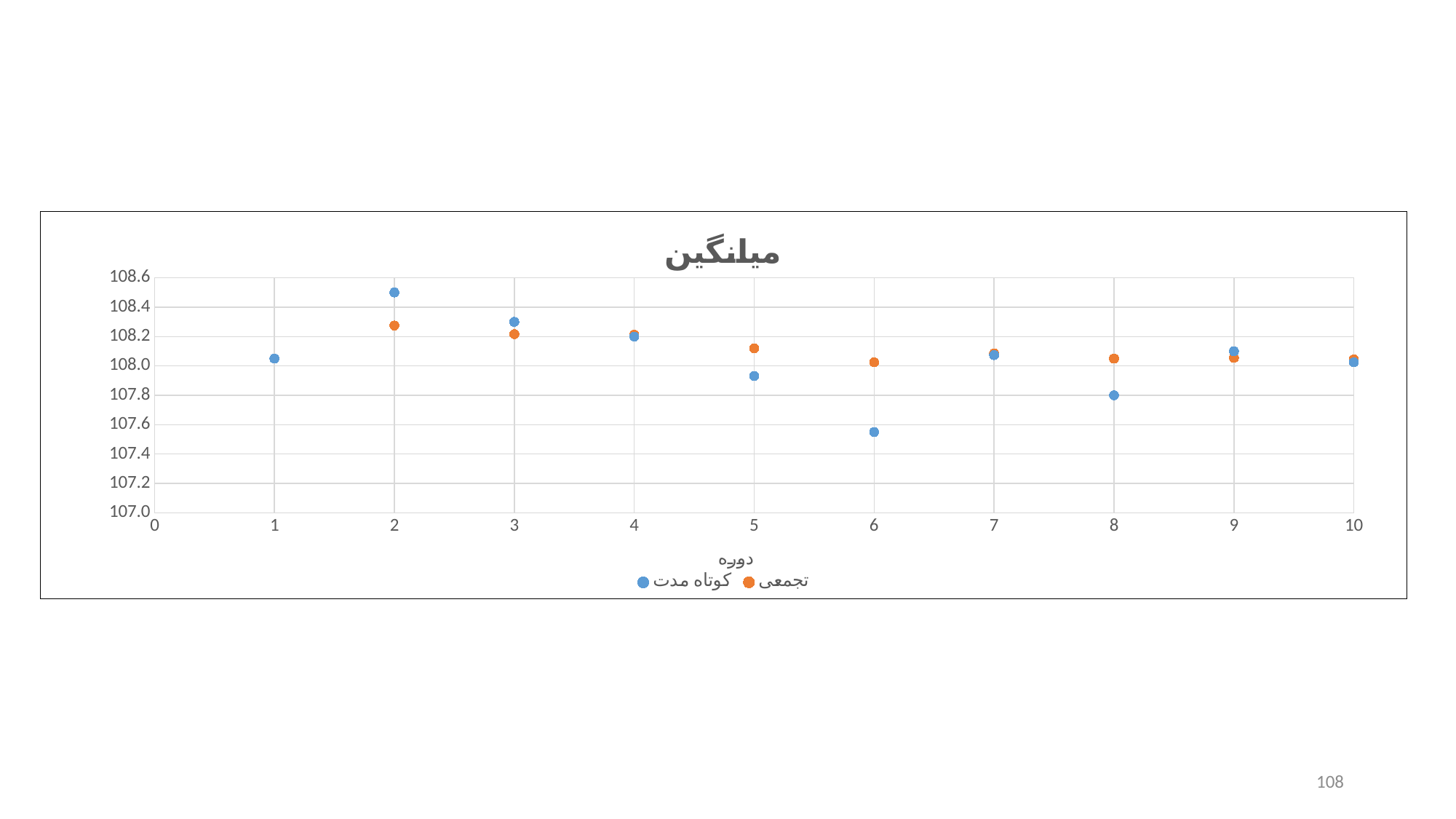
Is the value for کوتاه مدت at period 2 greater or less than 108.4? greater At period 6, which series has the higher value, کوتاه مدت or تجمعی? تجمعی How many series does the legend list? 2 Is the value for کوتاه مدت at period 6 greater or less than 107.8? less At period 2, which series has the higher value, کوتاه مدت or تجمعی? کوتاه مدت Is the value for تجمعی at period 5 greater or less than 108.0? greater What kind of chart is shown on the slide? scatter chart At which period does the کوتاه مدت series reach its lowest value? 6 How many periods (x-axis points) are plotted for the کوتاه مدت series? 10 What is the title of the chart? میانگین At which period does the کوتاه مدت series reach its highest value? 2